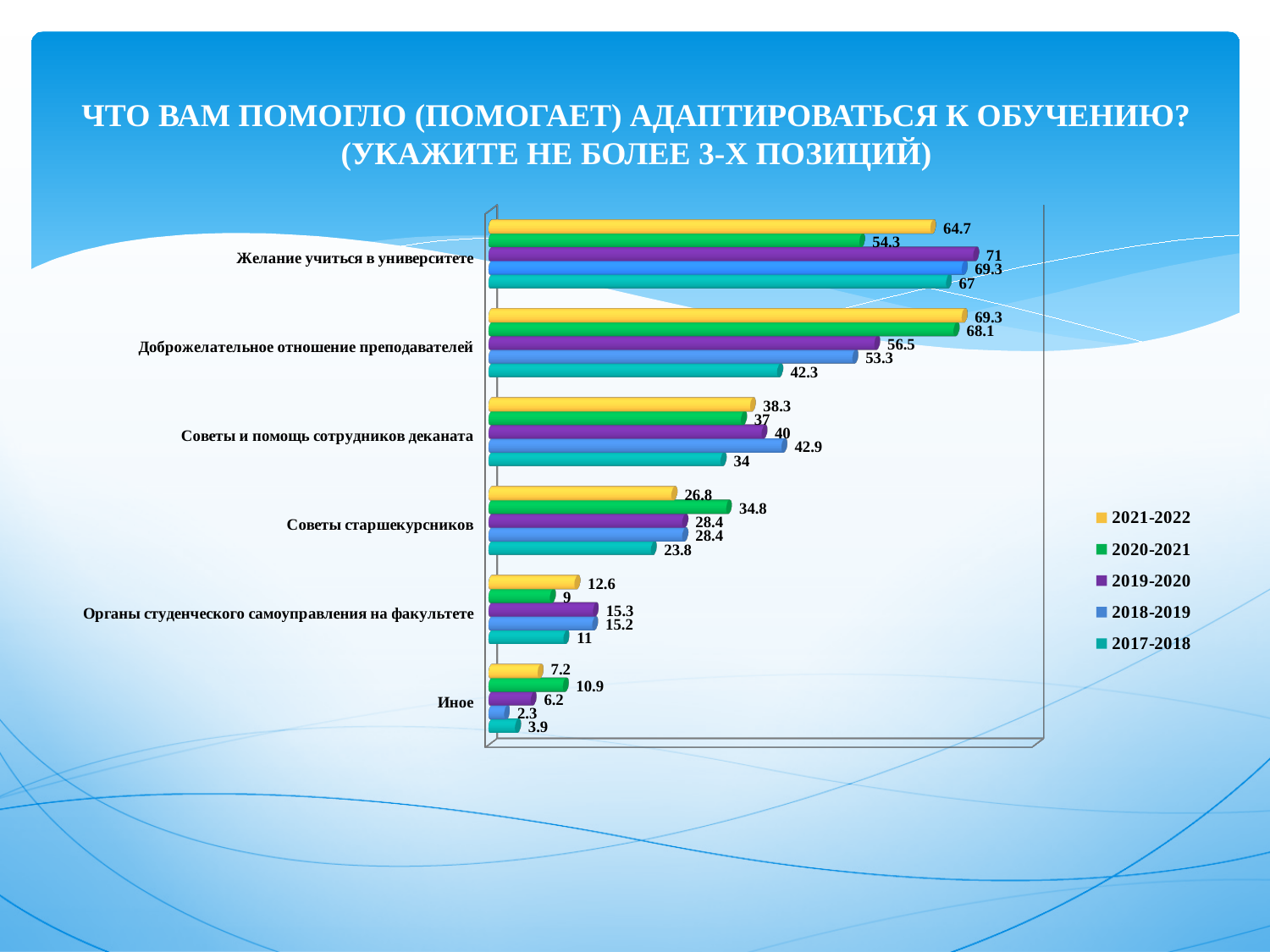
What is the value for "Советы старшекурсников" in the 2020-2021 series? 34.8 How many series does the legend list? 5 Which category has the lowest value in the 2017-2018 series? Иное How many categories are shown on the chart? 6 What is the value for "Доброжелательное отношение преподавателей" in the 2017-2018 series? 42.3 What kind of chart is shown on the slide? Bar chart Which colour represents the 2017-2018 series in the legend? Teal Which is larger for "Советы и помощь сотрудников деканата": the 2018-2019 value or the 2019-2020 value? 2018-2019 What is the value for "Иное" in the 2018-2019 series? 2.3 Which category has the highest value in the 2021-2022 series? Доброжелательное отношение преподавателей What is the value for "Желание учиться в университете" in the 2019-2020 series? 71 What is the difference between the 2021-2022 and 2020-2021 values for "Желание учиться в университете"? 10.4